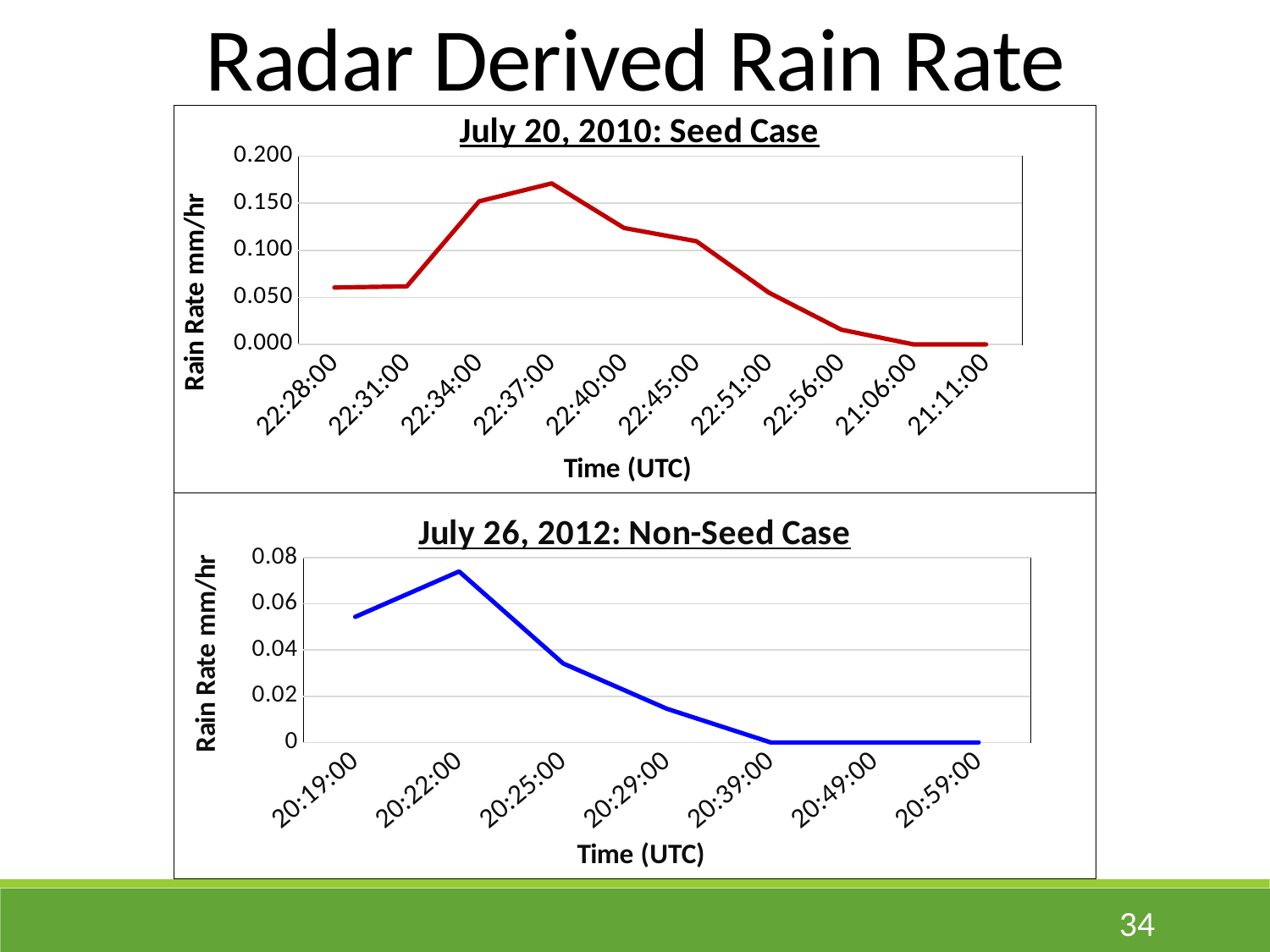
In the 'July 26, 2012: Non-Seed Case' chart, is the rain rate at 20:25:00 greater or less than 0.04? less In the 'July 26, 2012: Non-Seed Case' chart, does the rain rate rise or fall from 20:22:00 to 20:39:00? fall In the 'July 20, 2010: Seed Case' chart, is the rain rate at 22:56:00 greater or less than 0.050? less In the 'July 20, 2010: Seed Case' chart, at which time is the rain rate highest? 22:37:00 In the 'July 26, 2012: Non-Seed Case' chart, how many time points are shown on the x axis? 7 In the 'July 26, 2012: Non-Seed Case' chart, at which time is the rain rate highest? 20:22:00 In the 'July 26, 2012: Non-Seed Case' chart, what is the rain rate at 20:49:00? 0 What kind of chart is the 'July 26, 2012: Non-Seed Case' chart? line chart In the 'July 20, 2010: Seed Case' chart, how many time points are shown on the x axis? 10 In the 'July 20, 2010: Seed Case' chart, which has the larger rain rate, 22:40:00 or 22:51:00? 22:40:00 In the 'July 20, 2010: Seed Case' chart, is the rain rate at 22:34:00 greater or less than 0.100? greater In the 'July 20, 2010: Seed Case' chart, what is the rain rate at 21:11:00? 0.000